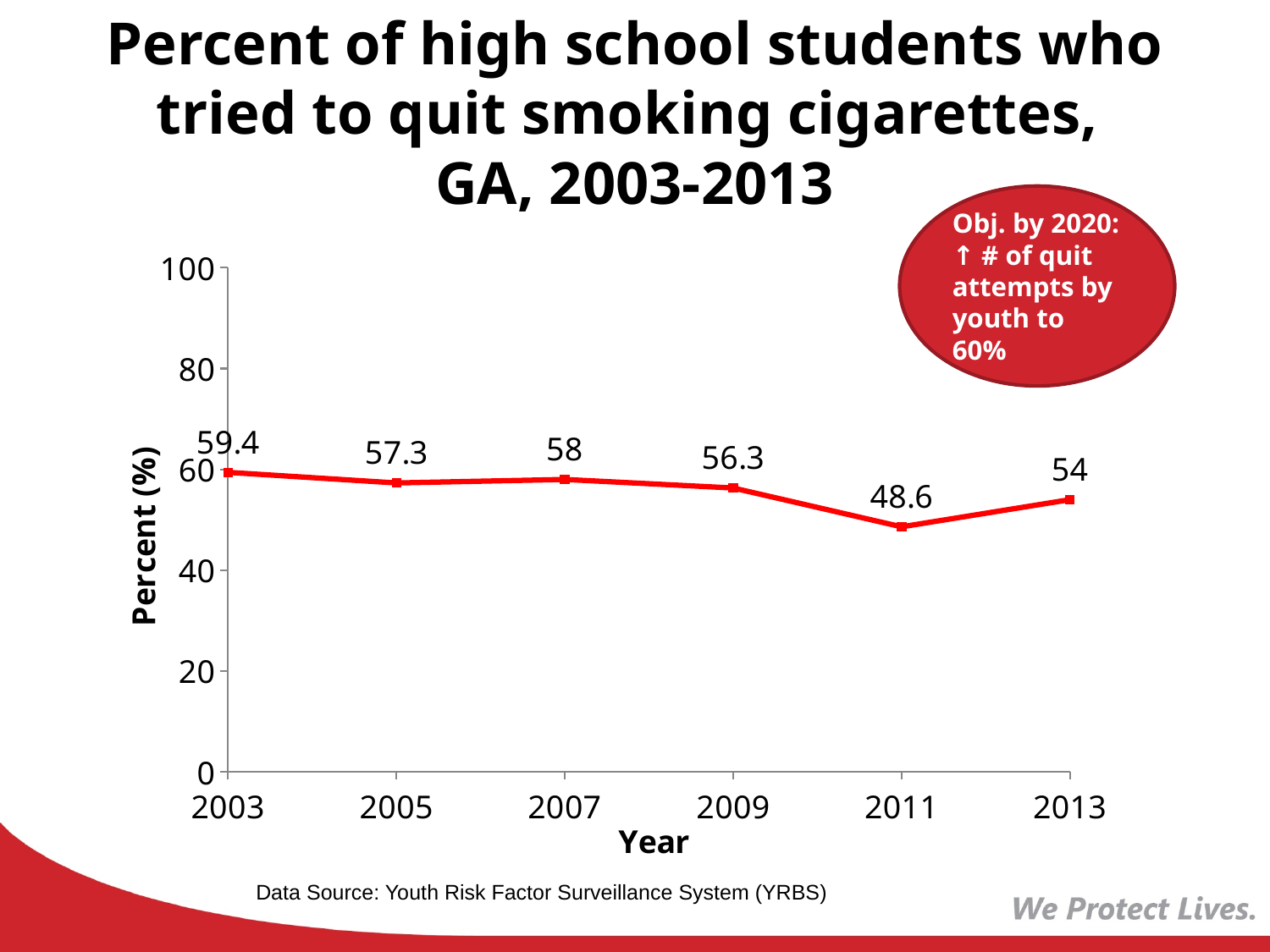
What value is shown for 2011? 48.6 What is the data source listed below the chart? Youth Risk Factor Surveillance System (YRBS) What type of chart is shown on the slide? Line chart Which year has a larger value, 2007 or 2009? 2007 What is the difference between the values for 2003 and 2011? 10.8 Which year has the highest percent? 2003 What was the percent of high school students who tried to quit smoking cigarettes in 2003? 59.4 What value is shown for 2013? 54 What is the label of the y-axis? Percent (%) How many data points are plotted on the chart? 6 Does the value rise or fall from 2011 to 2013? Rise Which year has the lowest percent? 2011